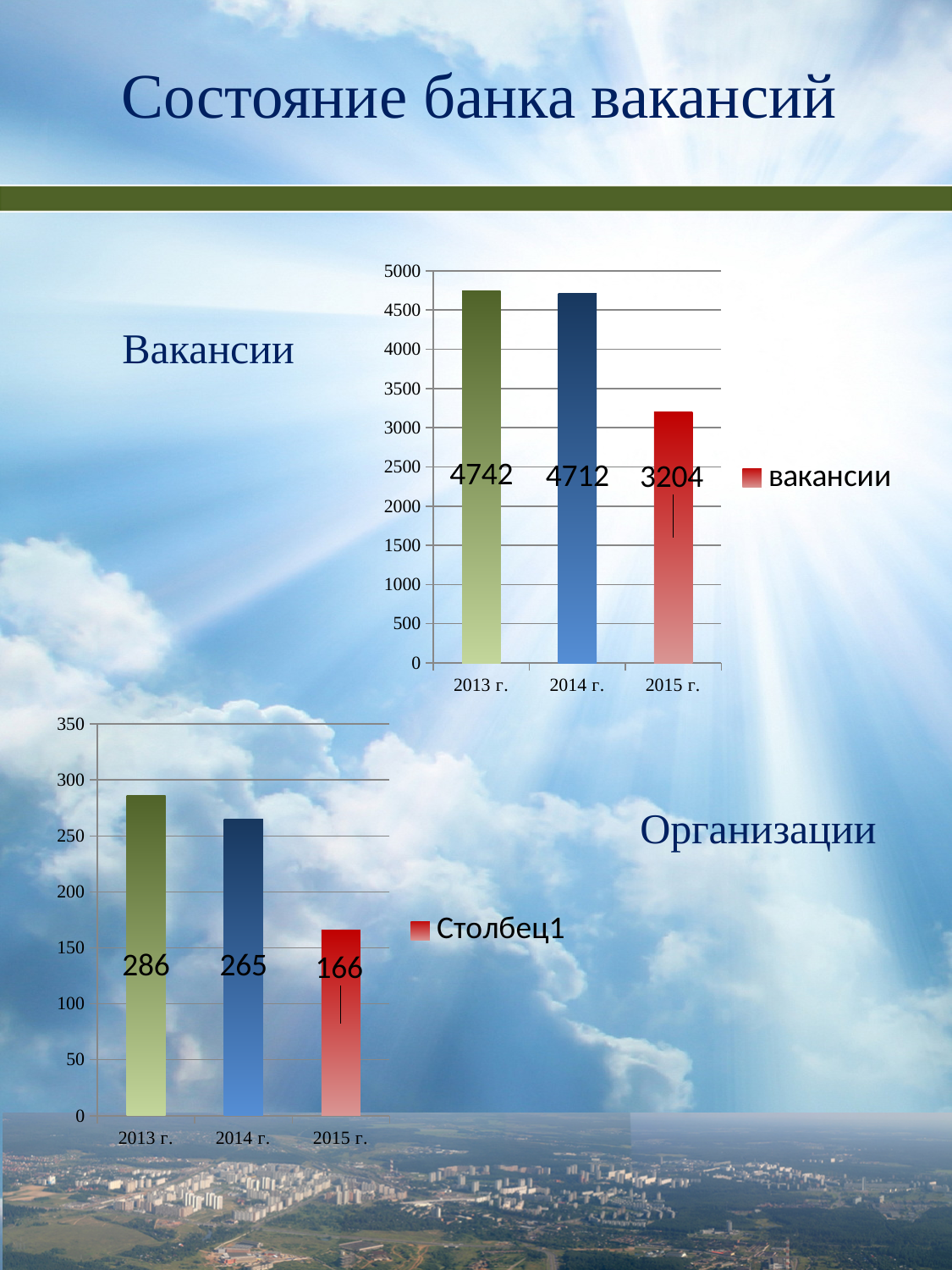
In the Организации chart (bottom), which year has the highest value? 2013 г. In the Вакансии chart (top), what is the difference between the values for 2014 г. and 2015 г.? 1508 In the Вакансии chart (top), what is the value for 2015 г.? 3204 In the Вакансии chart (top), how many years are shown on the x axis? 3 What kind of chart is the Организации chart (bottom)? bar chart In the Организации chart (bottom), what is the value for 2014 г.? 265 In the Организации chart (bottom), what is the value for 2015 г.? 166 What is the legend entry of the Организации chart (bottom)? Столбец1 In the Вакансии chart (top), what is the value for 2013 г.? 4742 In the Организации chart (bottom), do the values rise or fall from 2013 г. to 2015 г.? fall In the Организации chart (bottom), what is the difference between the values for 2013 г. and 2015 г.? 120 In the Вакансии chart (top), which year has the lowest value? 2015 г.